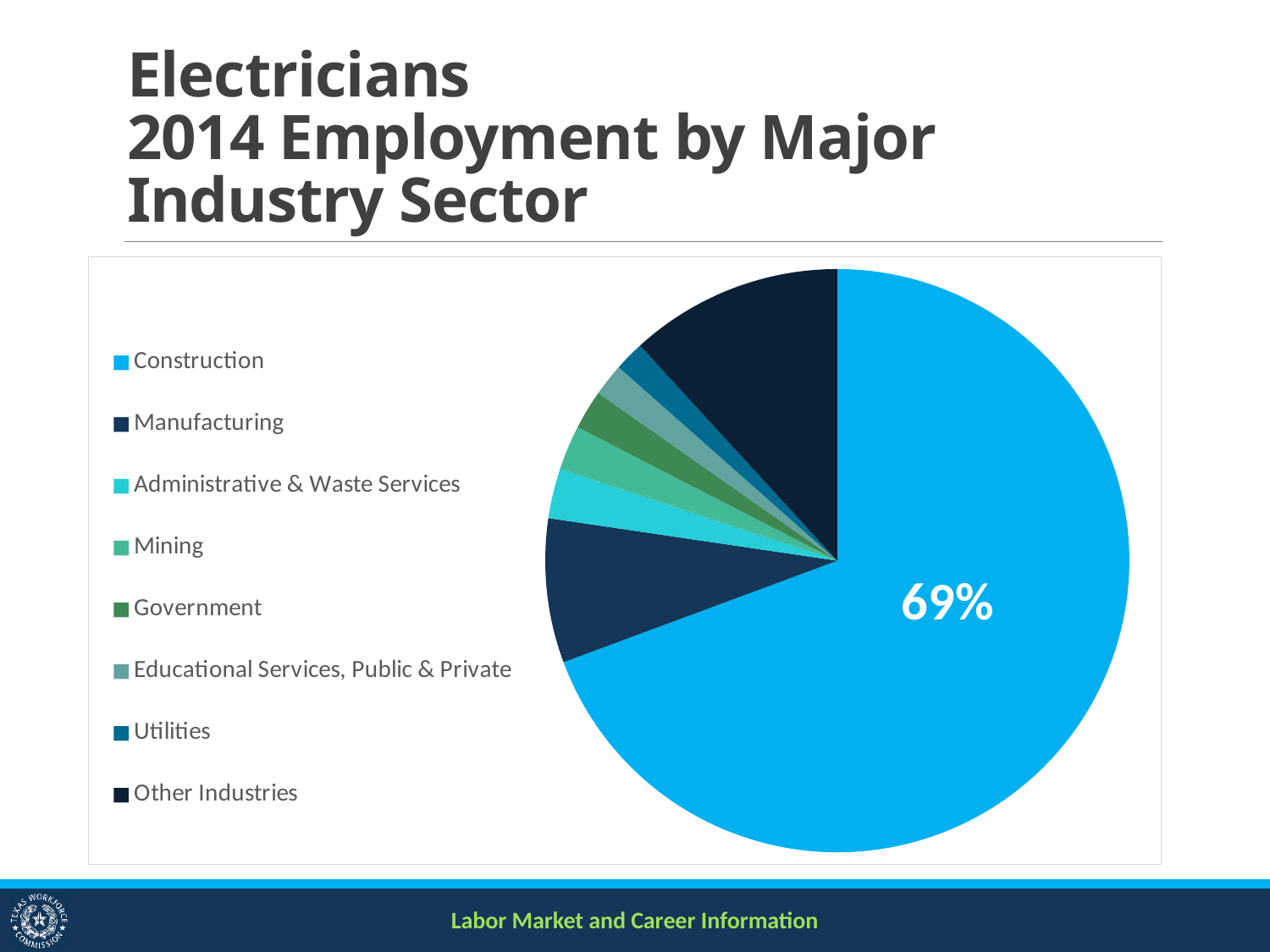
What is the only percentage value printed on the pie chart? 69% Which legend entry appears last in the legend? Other Industries What kind of chart is shown on the slide? Pie chart Which is larger, the slice for Other Industries or the slice for Utilities? Other Industries Which is larger, the slice for Other Industries or the slice for Government? Other Industries Which industry sector has the largest slice of the pie? Construction How many industry sectors are listed in the legend? 8 Which is larger, the slice for Construction or the slice for Manufacturing? Construction What is the title of the slide containing the chart? Electricians 2014 Employment by Major Industry Sector What share of 2014 electrician employment is in Construction? 69%